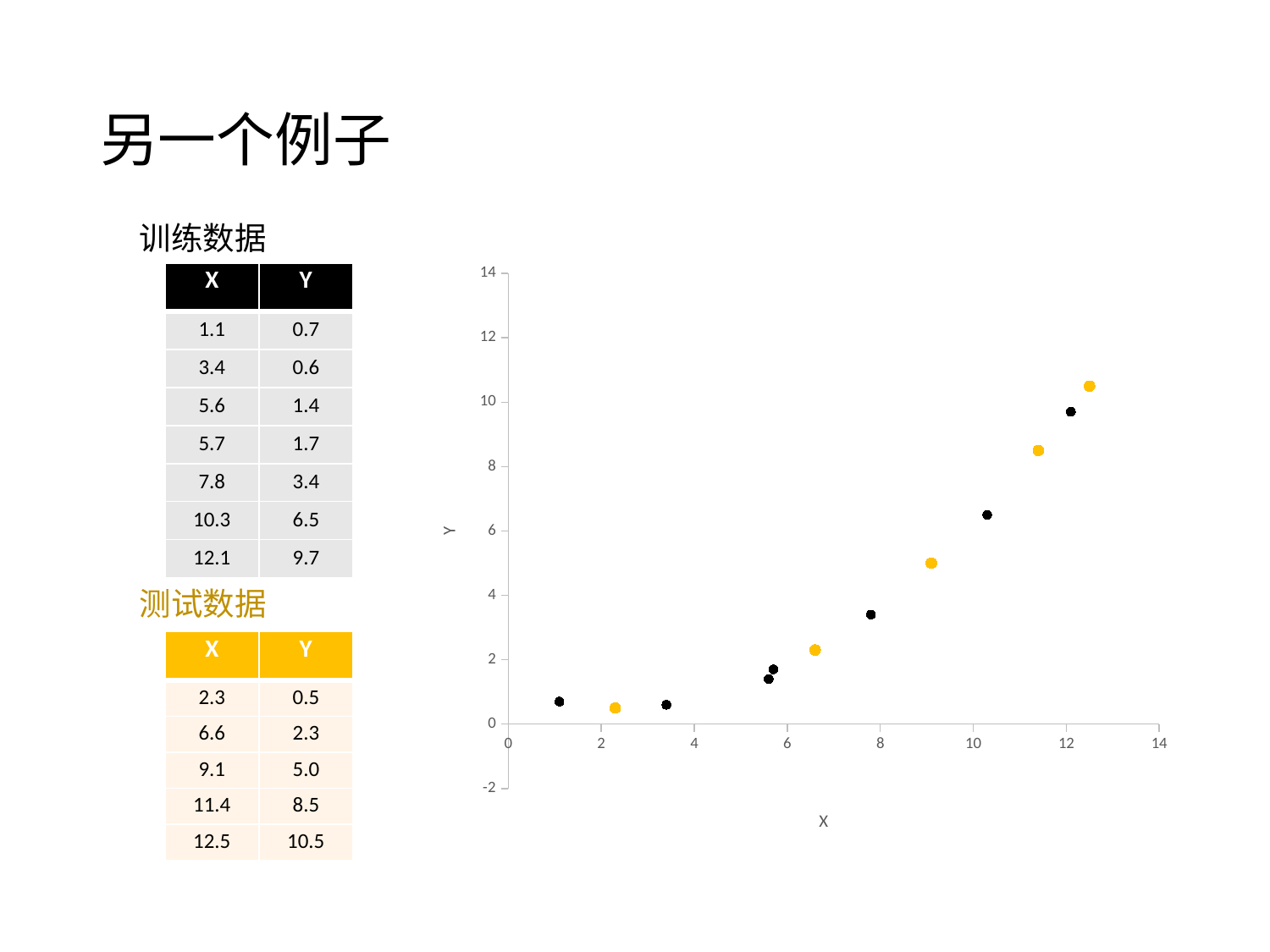
What kind of chart is shown on the slide? scatter chart What is the difference in Y between the test point at X = 12.5 and the training point at X = 12.1? 0.8 How many data series are plotted on the chart? 2 Which has the larger Y value: the point at X = 7.8 or the point at X = 9.1? X = 9.1 How many yellow (test data) points are plotted on the chart? 5 Do the Y values generally rise or fall as X increases along the x axis? rise How many black (training data) points are plotted on the chart? 7 What is the Y value of the lowest point on the chart? 0.5 How many data points are plotted on the chart in total? 12 Is the Y value of the point at X = 7.8 greater or less than 4? less What is the Y value of the training data point at X = 10.3? 6.5 What is the Y value of the highest point on the chart? 10.5